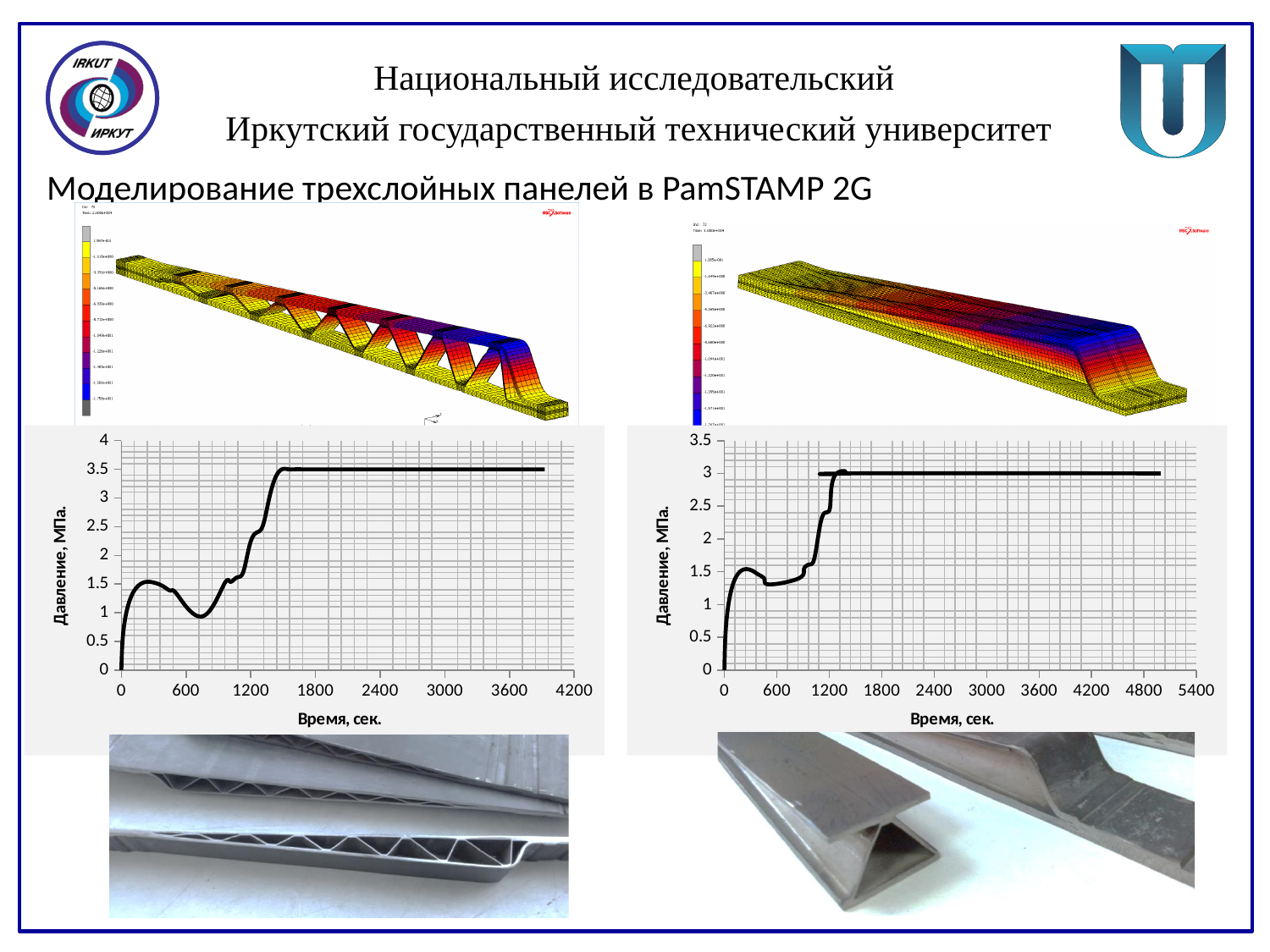
What kind of chart is the left chart on the slide? line chart On the left chart, is the pressure at 600 seconds greater or less than 1.5? less On the right chart, what is the x-axis label? Время, сек. Which chart reaches a higher plateau pressure, the left chart or the right chart? the left chart On the right chart, at what pressure value does the curve level off (plateau)? 3 On the right chart, does the pressure generally rise or fall between 0 and 1200 seconds? rise What is the highest tick value on the x-axis of the right chart? 5400 On the left chart, is the pressure at 2400 seconds greater or less than 3? greater What kind of chart is the right chart on the slide? line chart On the left chart, what is the y-axis label? Давление, МПа. On the right chart, is the pressure at 600 seconds greater or less than 2? less On the left chart, at what pressure value does the curve level off (plateau)? 3.5